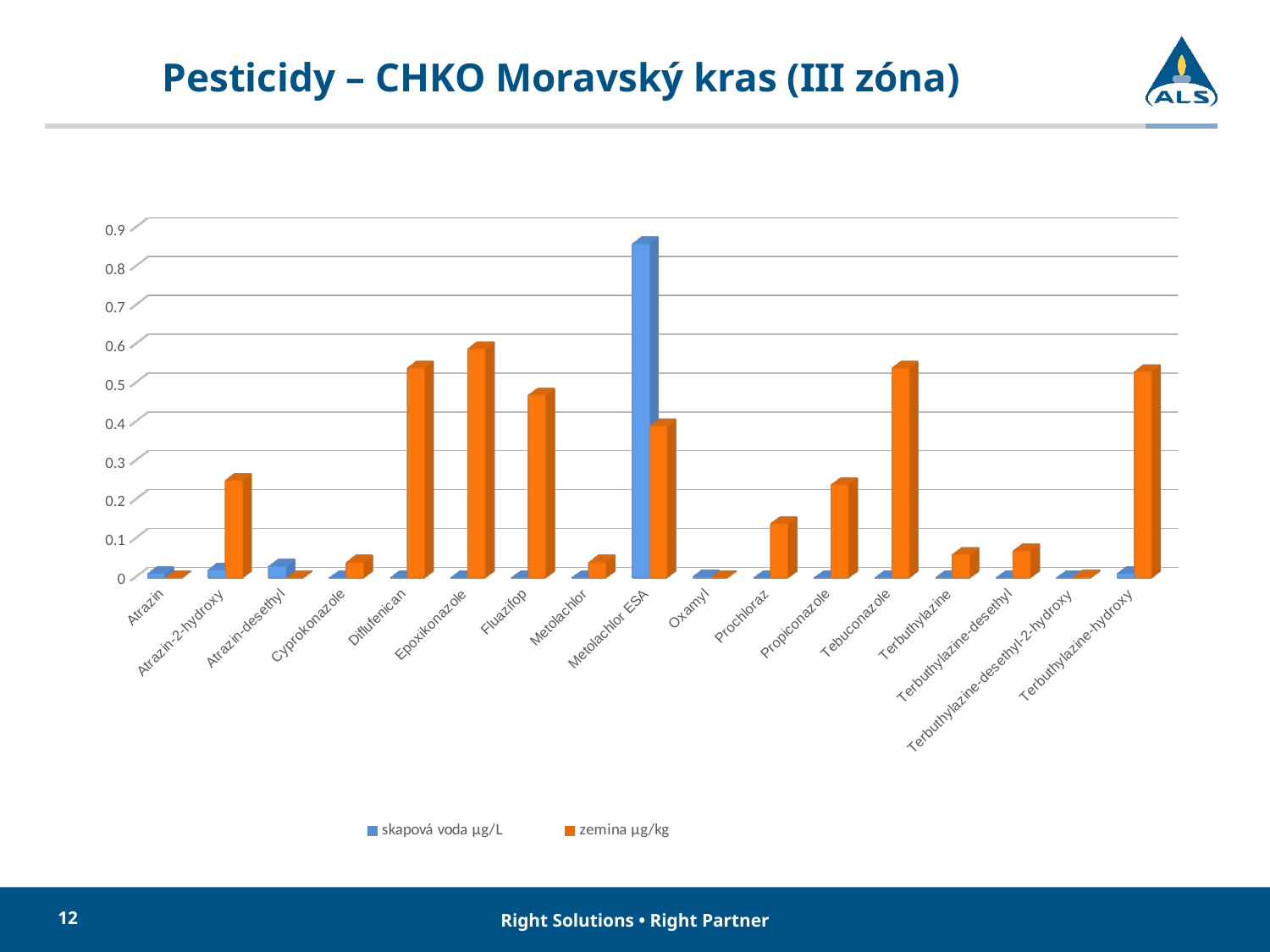
How many pesticide categories are shown on the x axis? 17 Which series is shown in orange in the legend? zemina µg/kg For Metolachlor ESA, which series has the larger value: skapová voda µg/L or zemina µg/kg? skapová voda µg/L Is the zemina µg/kg value for Atrazin-2-hydroxy greater or less than 0.2? greater What kind of chart is shown on the slide? bar chart Which category has the highest value for the zemina µg/kg series? Epoxikonazole Is the skapová voda µg/L value for Metolachlor ESA greater or less than 0.8? greater Is the zemina µg/kg value for Epoxikonazole greater or less than 0.5? greater How many series does the legend list? 2 Which category has the highest value for the skapová voda µg/L series? Metolachlor ESA